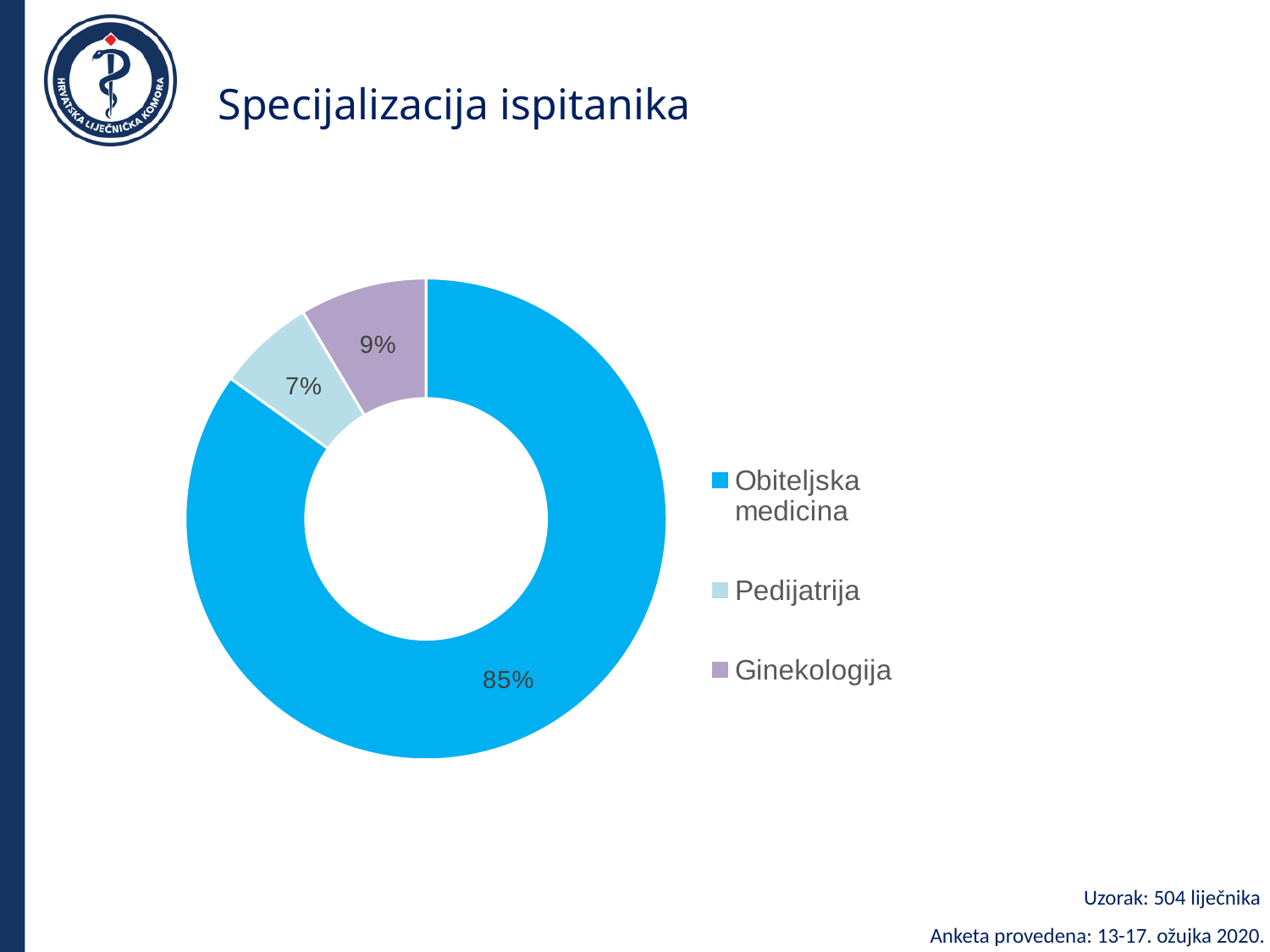
Which specialisation has the largest share of respondents? Obiteljska medicina What share of respondents specialise in Obiteljska medicina? 85% What share of respondents specialise in Pedijatrija? 7% What share of respondents specialise in Ginekologija? 9% What is the difference in percentage points between the Ginekologija share and the Pedijatrija share? 2 What is the difference in percentage points between the Obiteljska medicina share and the Ginekologija share? 76 Which specialisation has the smallest share of respondents? Pedijatrija How many specialisation categories are shown in the chart? 3 Which has a larger share, Pedijatrija or Ginekologija? Ginekologija What is the title of the slide? Specijalizacija ispitanika What kind of chart is shown on the slide? Pie chart (doughnut) What colour is the Ginekologija slice in the chart? Purple